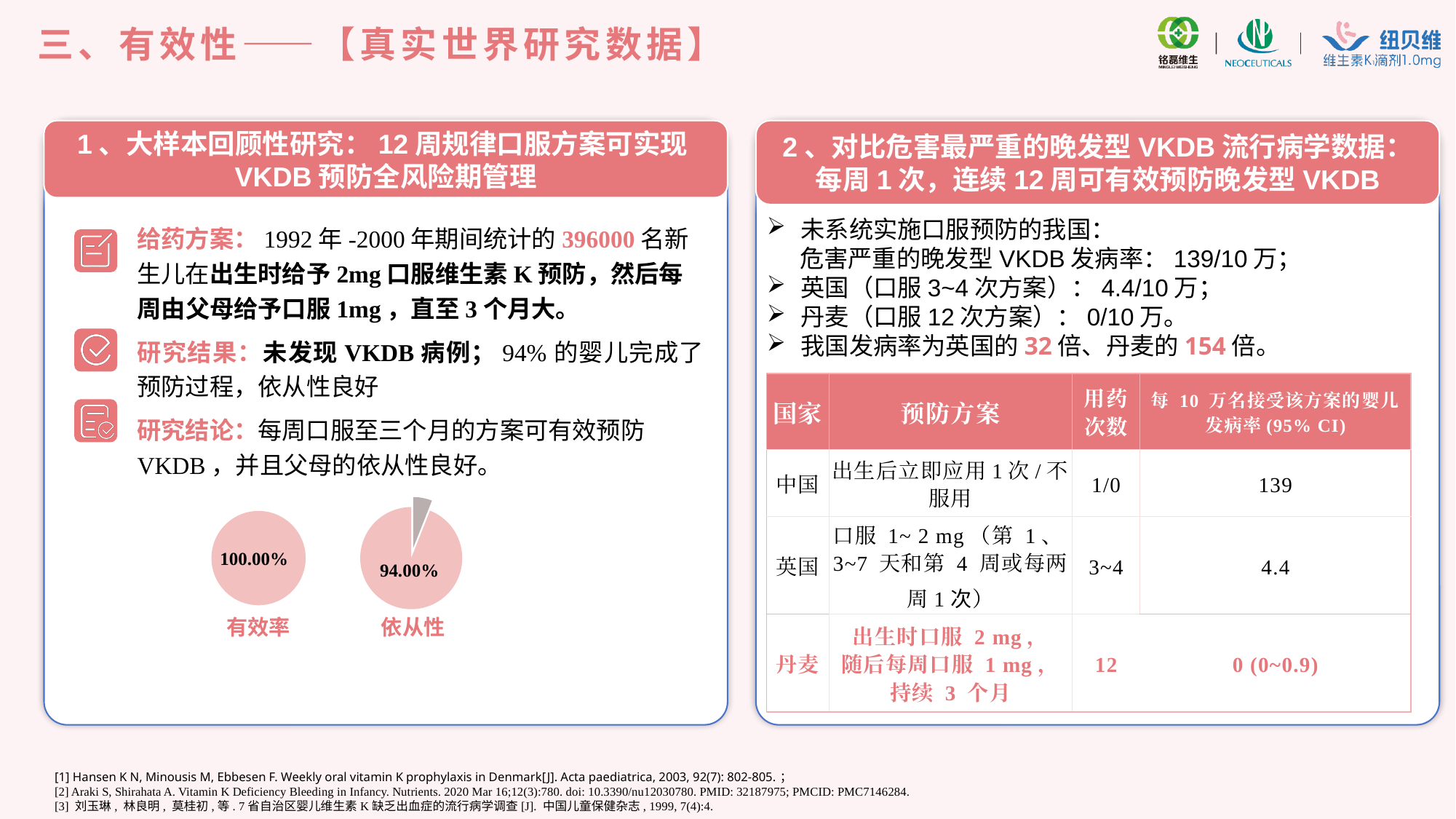
Which pie chart shows the larger value, 有效率 or 依从性? 有效率 What colour is the main slice of the 依从性 pie chart? Pink What value is shown on the 有效率 pie chart? 100.00% By how many percentage points does the 有效率 value exceed the 依从性 value? 6 percentage points In the 依从性 pie chart, what share of the pie does the grey slice represent? 6.00% What value is shown on the 依从性 pie chart? 94.00% What kind of charts are shown in the lower part of the left panel? Pie charts What is the label under the left pie chart? 有效率 How many pie charts are shown on the slide? 2